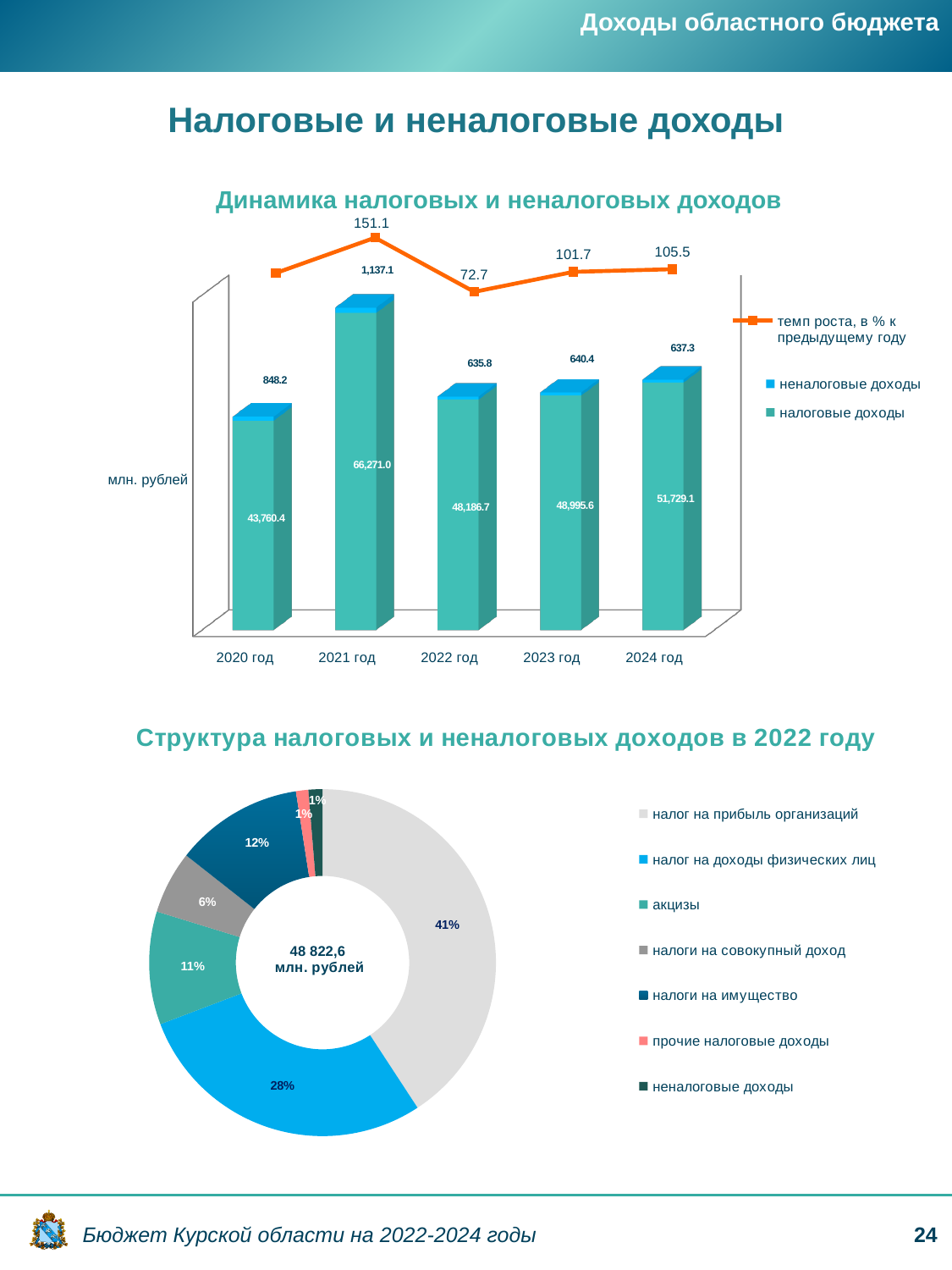
What kind of chart is 'Структура налоговых и неналоговых доходов в 2022 году'? donut (pie) chart In the chart 'Динамика налоговых и неналоговых доходов', do налоговые доходы rise or fall from 2022 год to 2024 год? rise In the chart 'Динамика налоговых и неналоговых доходов', what is the темп роста value for 2022 год? 72.7 In the chart 'Динамика налоговых и неналоговых доходов', how many series does the legend list? 3 In the chart 'Динамика налоговых и неналоговых доходов', which year has the lowest налоговые доходы? 2020 год In the chart 'Динамика налоговых и неналоговых доходов', what is the value of налоговые доходы for 2021 год? 66,271.0 In the chart 'Структура налоговых и неналоговых доходов в 2022 году', which category has the largest share? налог на прибыль организаций In the chart 'Динамика налоговых и неналоговых доходов', what is the difference between налоговые доходы in 2021 год and 2020 год? 22,510.6 In the chart 'Динамика налоговых и неналоговых доходов', what is the value of неналоговые доходы for 2020 год? 848.2 In the chart 'Структура налоговых и неналоговых доходов в 2022 году', what share does налог на доходы физических лиц have? 28% In the chart 'Динамика налоговых и неналоговых доходов', which year has the highest налоговые доходы? 2021 год In the chart 'Динамика налоговых и неналоговых доходов', what is the total of налоговые and неналоговые доходы for 2021 год? 67,408.1